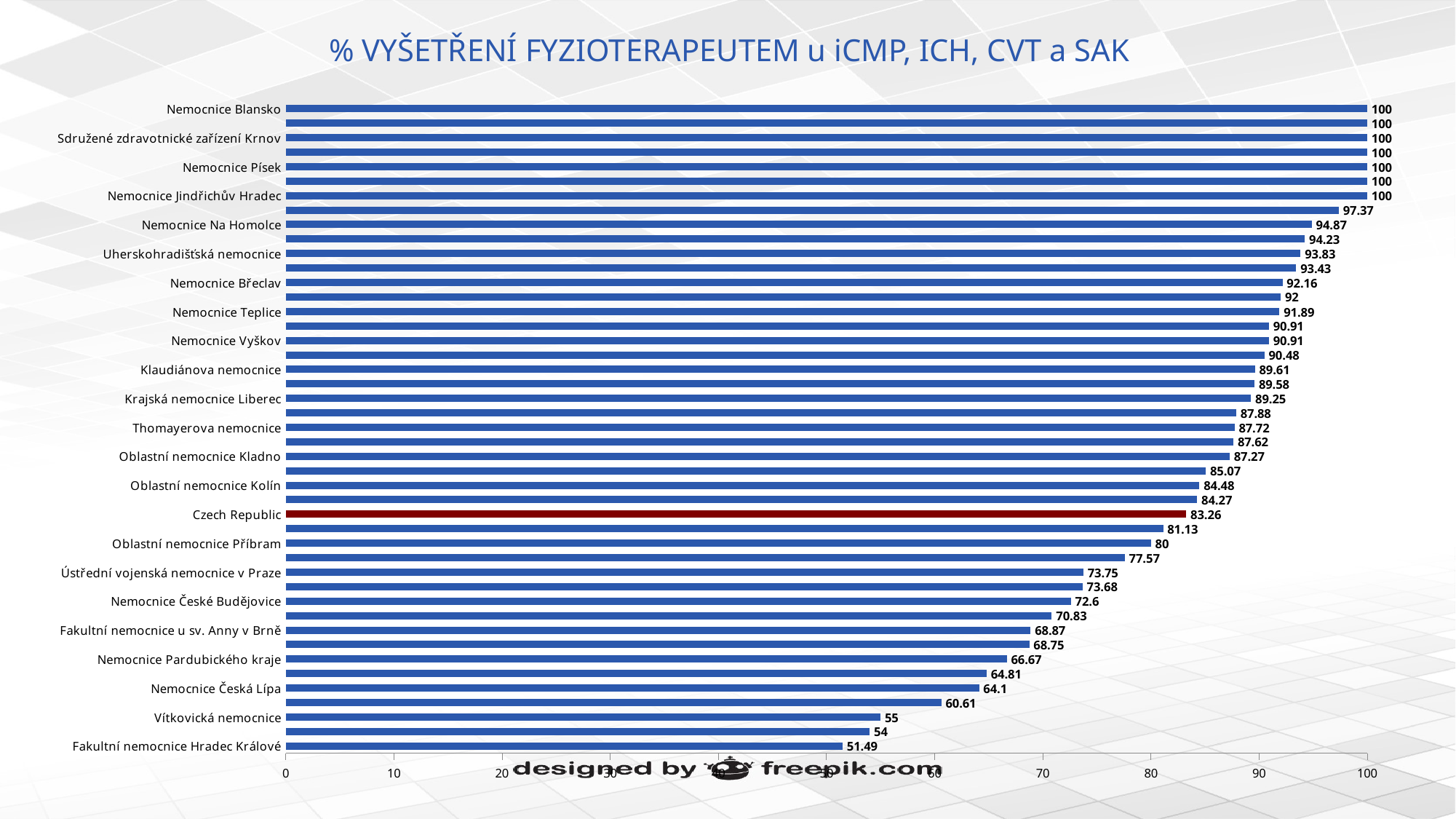
What is the value for Nemocnice Na Homolce? 94.87 What is the value for Czech Republic? 83.26 What is the difference between the values for Czech Republic and Fakultní nemocnice Hradec Králové? 31.77 What is the value for Fakultní nemocnice Hradec Králové? 51.49 What is the difference between the values for Oblastní nemocnice Příbram and Vítkovická nemocnice? 25 What is the value for Oblastní nemocnice Příbram? 80 What is the highest value shown on the chart? 100 Which labelled category has the lowest value? Fakultní nemocnice Hradec Králové Which bar is highlighted in a different colour (dark red) from the others? Czech Republic Which has a larger value, Nemocnice Teplice or Nemocnice České Budějovice? Nemocnice Teplice What kind of chart is shown on the slide? Bar chart What is the value for Vítkovická nemocnice? 55